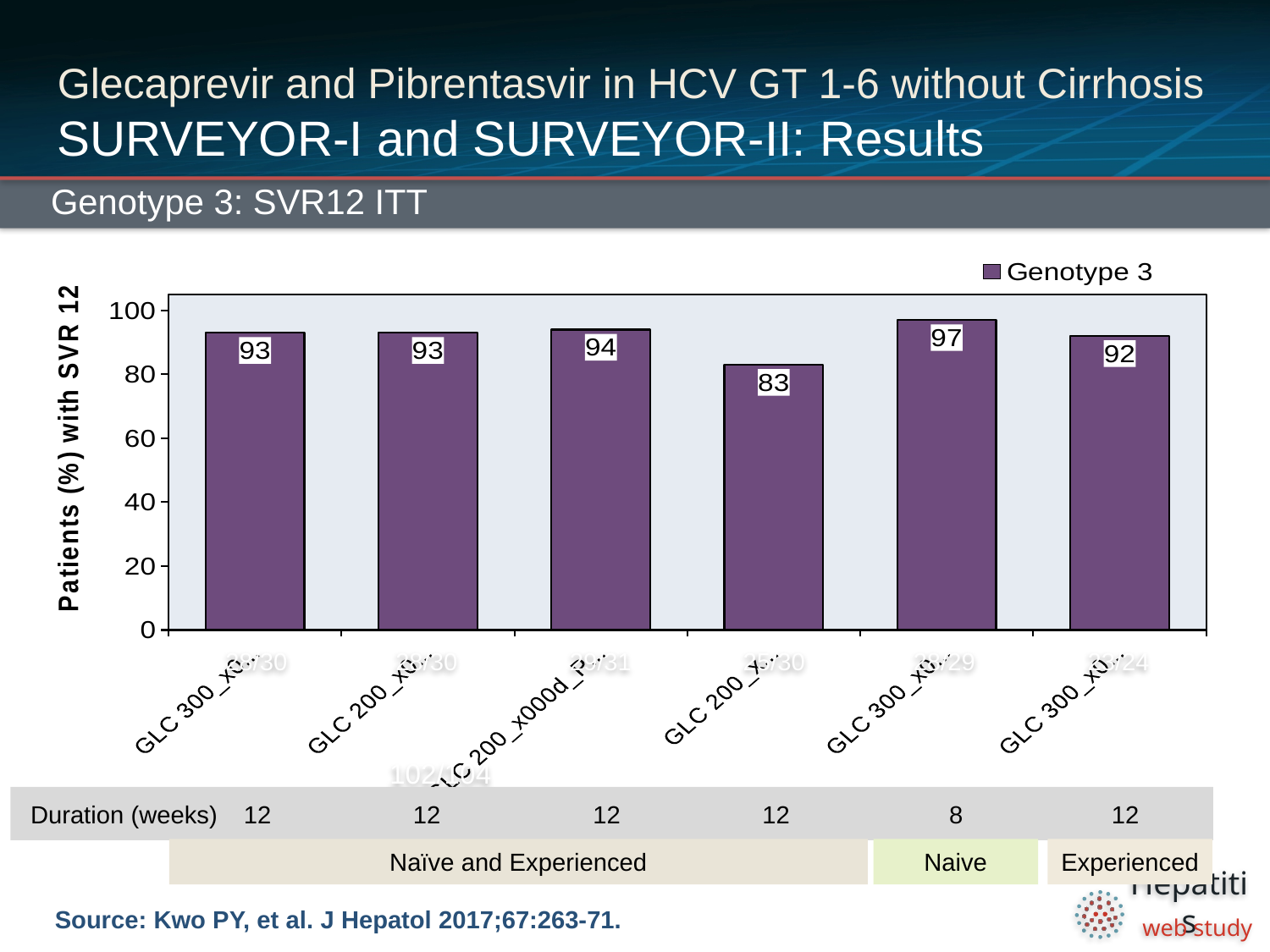
What is the label on the vertical axis of the chart? Patients (%) with SVR 12 What is the difference between the highest bar (97) and the lowest bar (83)? 14 What is the legend entry for the series in the chart? Genotype 3 How many series does the legend list? 1 What is the SVR12 value for the 12-week Experienced group (sixth bar)? 92 Which bar has the lowest value in the chart? the fourth bar from the left, 83 What kind of chart is shown on the slide? bar chart How many bars are plotted in the chart? 6 Which bar has the highest value in the chart? the fifth bar (8-week Naive group), 97 What is the value shown on the fourth bar from the left? 83 What is the SVR12 value for the 8-week Naive group (fifth bar)? 97 What is the value shown on the third bar from the left? 94